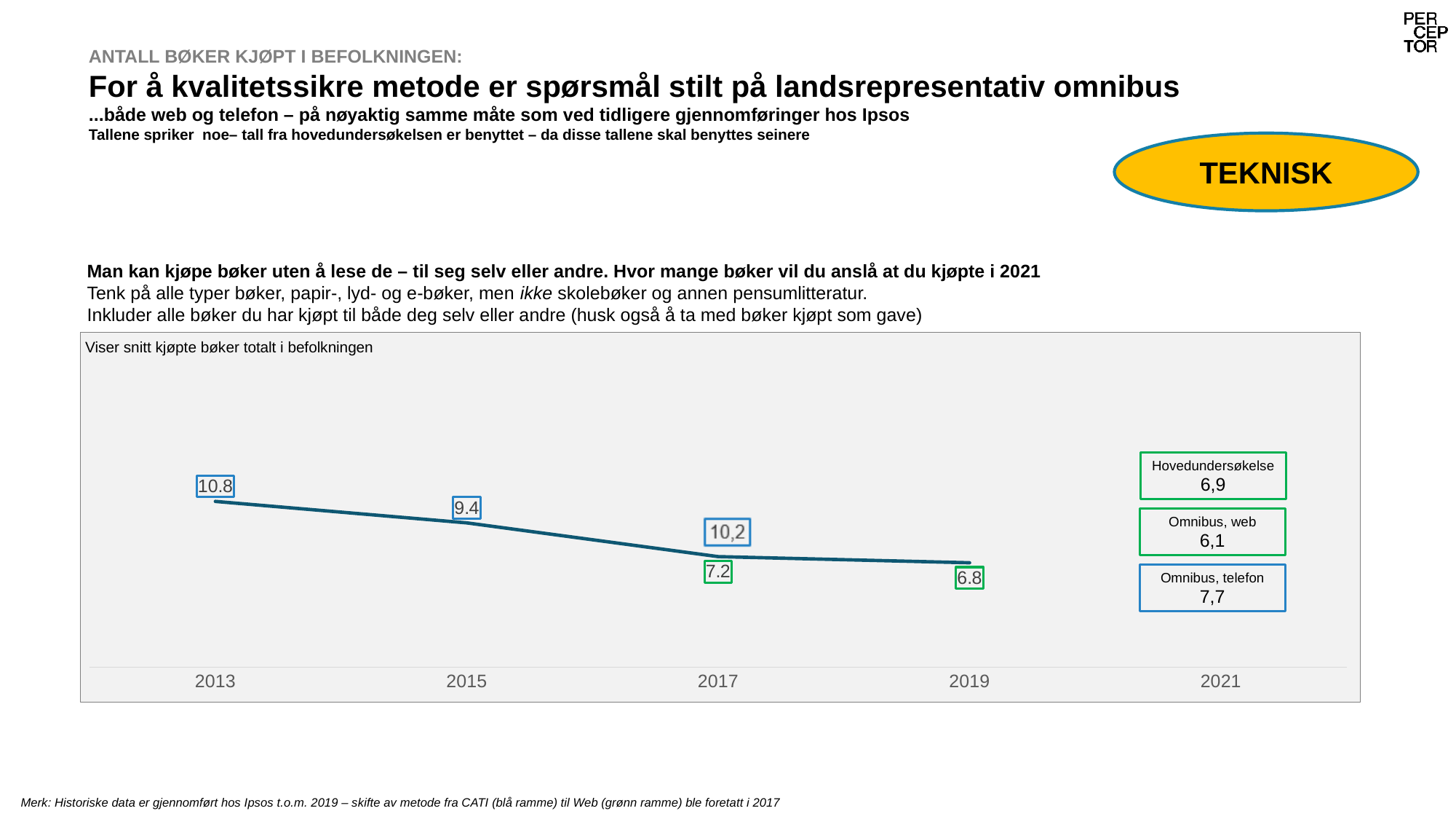
What value is shown for 'Omnibus, web' in 2021? 6,1 Which year has the highest value on the plotted line? 2013 What is the value plotted for 2013? 10.8 What is the green-framed value shown for 2017? 7.2 What is the difference between the 2013 value and the 2015 value on the line? 1.4 What type of chart is shown on the slide? line chart What is the value plotted on the line for 2019? 6.8 What is the value plotted for 2015? 9.4 What is the blue-framed value shown for 2017? 10,2 What value is shown for 'Hovedundersøkelse' in 2021? 6,9 Does the plotted line rise or fall from 2013 to 2019? fall What value is shown for 'Omnibus, telefon' in 2021? 7,7